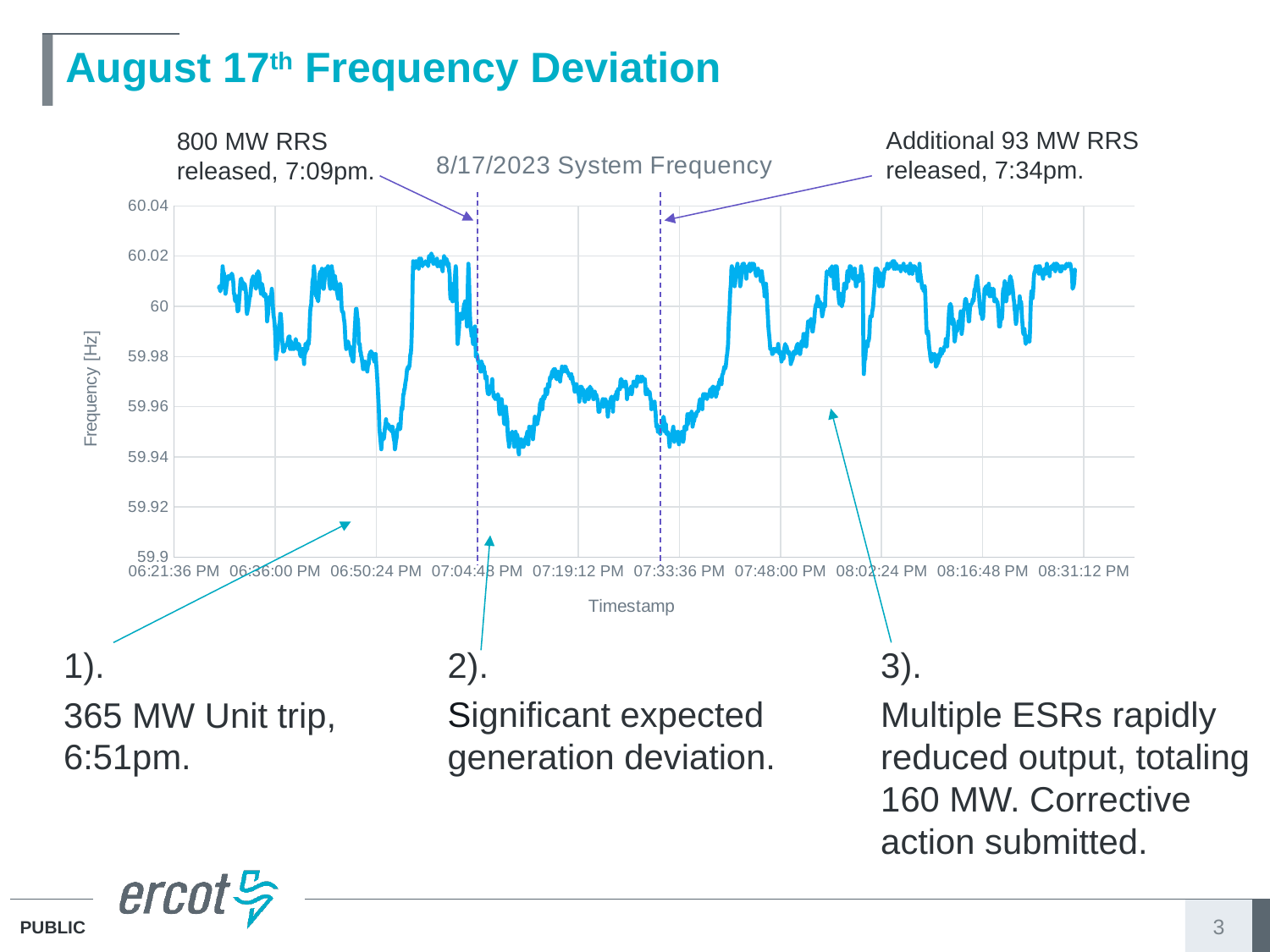
Which is larger, the frequency value at 07:33:36 PM or the frequency value at 08:31:12 PM? 08:31:12 PM What is the label of the vertical axis of the chart? Frequency [Hz] Is the highest frequency value plotted on the chart greater or less than 60? greater What is the title of the chart? 8/17/2023 System Frequency Is the lowest frequency value plotted on the chart greater or less than 59.96? less Is the frequency value at 07:48:00 PM greater or less than 60? less What kind of chart is shown on the slide? line chart How many timestamp tick labels are shown along the x axis of the chart? 10 What is the highest value shown on the vertical axis of the chart? 60.04